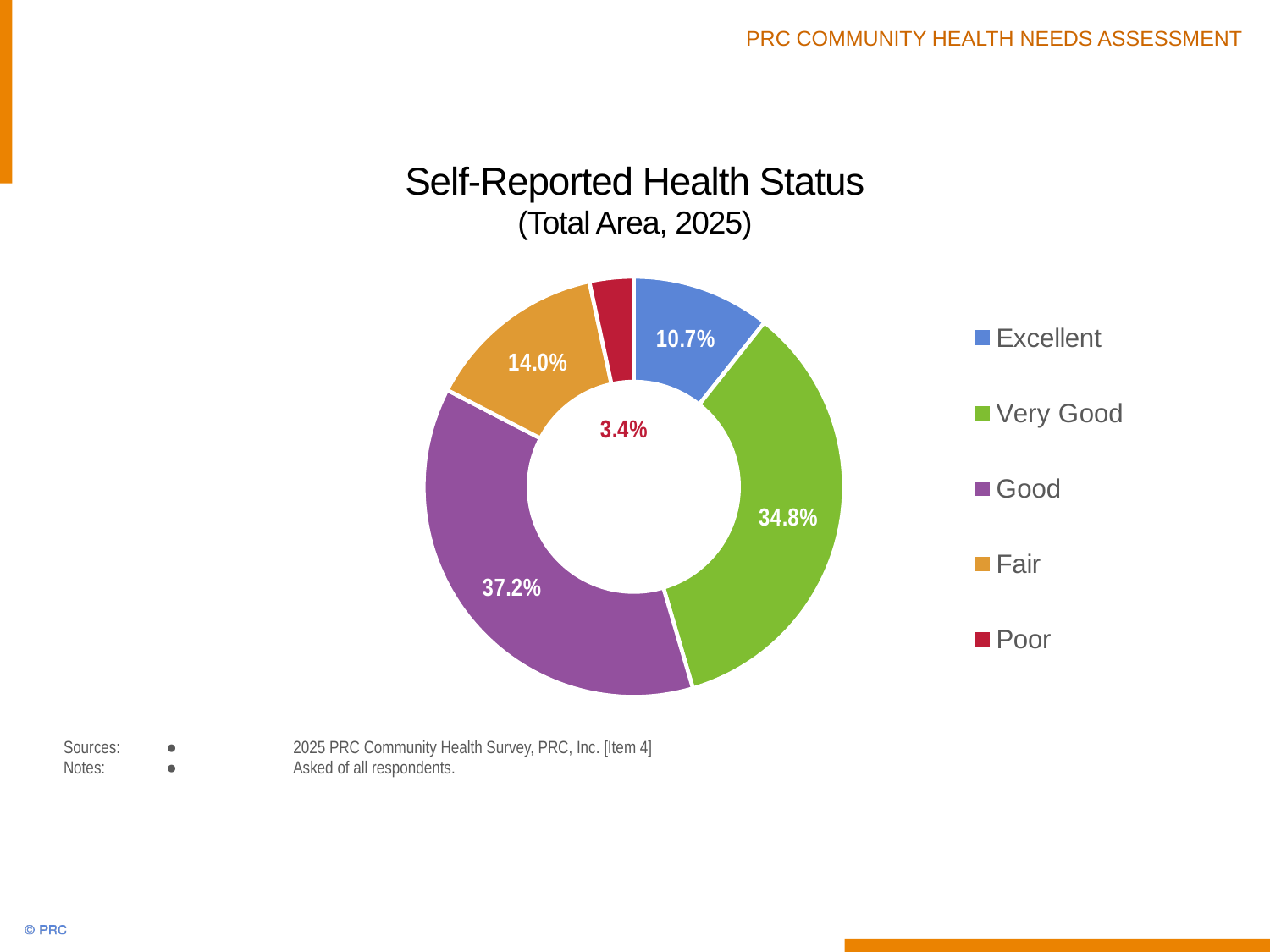
What percentage of respondents reported their health status as Fair? 14.0% What percentage of respondents reported their health status as Very Good? 34.8% What percentage of respondents reported their health status as Excellent? 10.7% Which health status category has the largest share? Good Which is larger, the share for Fair or the share for Excellent? Fair What type of chart is used to show Self-Reported Health Status? Doughnut (pie) chart What is the difference in percentage points between the Good and Very Good shares? 2.4 How many health status categories are shown in the chart? 5 What is the title of the chart? Self-Reported Health Status (Total Area, 2025) What percentage of respondents reported their health status as Poor? 3.4% Which health status category has the smallest share? Poor What percentage of respondents reported their health status as Good? 37.2%